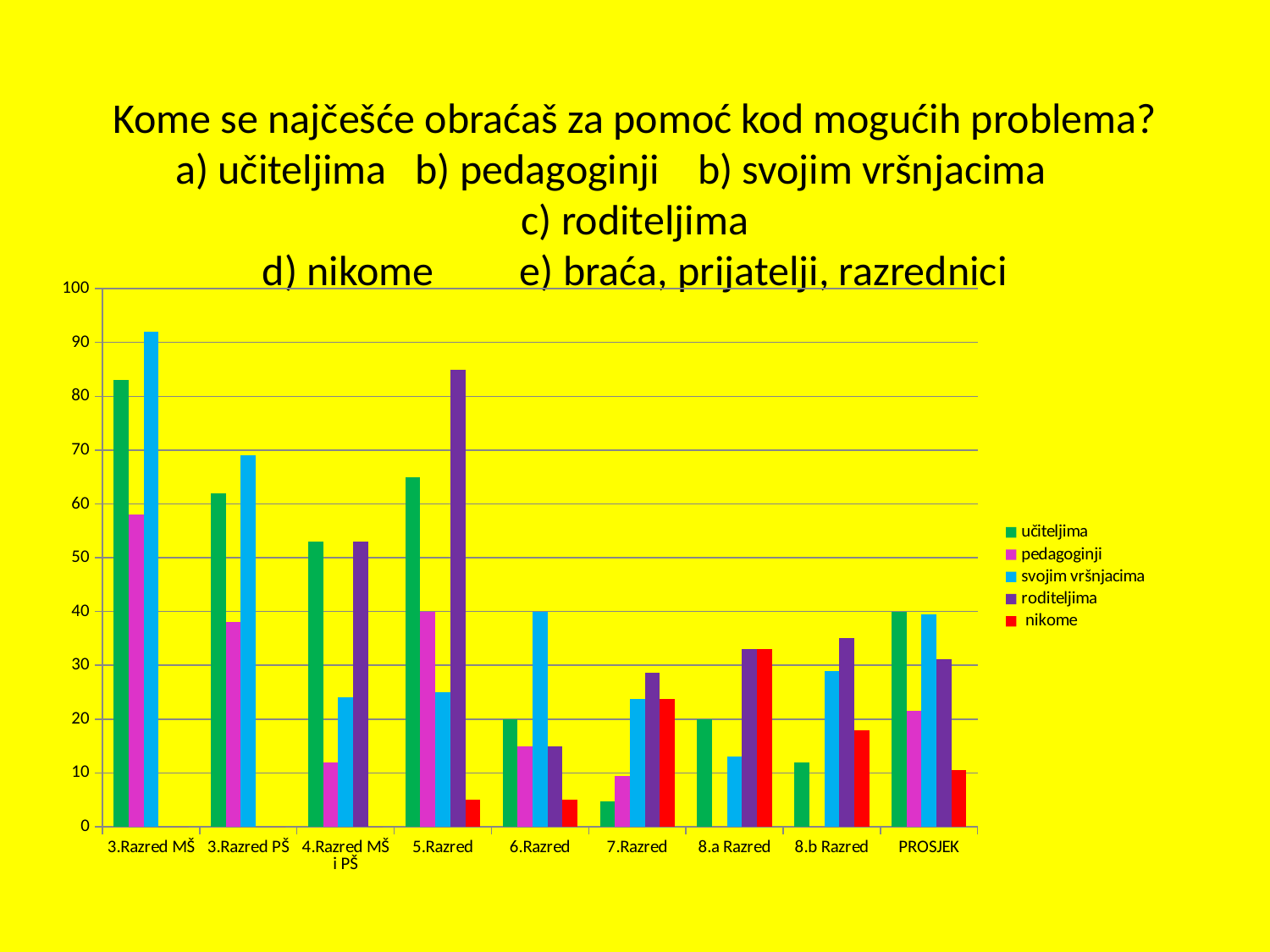
Which category has the lowest value for the 'učiteljima' series? 7.Razred For 3.Razred PŠ, which is larger: the 'učiteljima' value or the 'svojim vršnjacima' value? svojim vršnjacima How many series does the chart's legend list? 5 What colour represents the 'nikome' series in the legend? red Is the 'roditeljima' value for 5.Razred greater or less than 80? greater Which category has the highest value for the 'roditeljima' series? 5.Razred Is the 'pedagoginji' value for 4.Razred MŠ i PŠ greater or less than 20? less What kind of chart is shown on the slide? bar chart Which category has the highest value for the 'svojim vršnjacima' series? 3.Razred MŠ Is the 'učiteljima' value for 3.Razred MŠ greater or less than 80? greater For 6.Razred, which is larger: the 'učiteljima' value or the 'svojim vršnjacima' value? svojim vršnjacima How many categories are shown along the x axis of the chart? 9